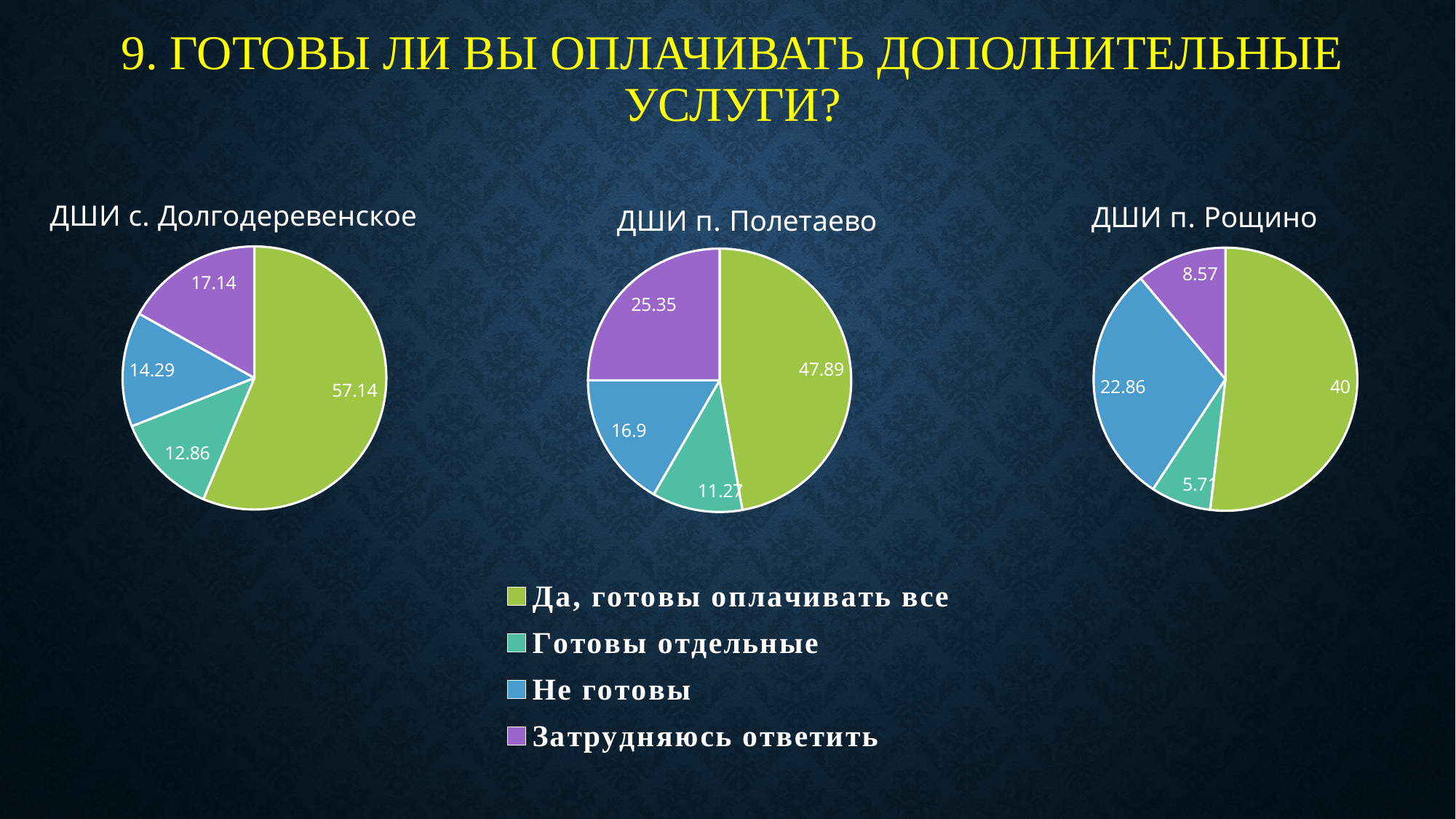
In the 'ДШИ п. Рощино' pie chart, which is larger: 'Не готовы' or 'Затрудняюсь ответить'? Не готовы In the 'ДШИ п. Полетаево' pie chart, what is the difference between 'Затрудняюсь ответить' and 'Не готовы'? 8.45 In the 'ДШИ п. Полетаево' pie chart, what is the value for 'Затрудняюсь ответить'? 25.35 What type of chart is used on this slide? Pie chart In the 'ДШИ п. Рощино' pie chart, what is the value for 'Не готовы'? 22.86 How many entries does the legend list? 4 How many slices does the 'ДШИ п. Полетаево' pie chart have? 4 In the 'ДШИ п. Рощино' pie chart, which category has the smallest slice? Готовы отдельные In the 'ДШИ с. Долгодеревенское' pie chart, which category has the smallest slice? Готовы отдельные In the 'ДШИ п. Полетаево' pie chart, which category has the largest slice? Да, готовы оплачивать все Which chart has the larger value for 'Да, готовы оплачивать все': 'ДШИ с. Долгодеревенское' or 'ДШИ п. Рощино'? ДШИ с. Долгодеревенское In the 'ДШИ с. Долгодеревенское' pie chart, what is the value for 'Да, готовы оплачивать все'? 57.14